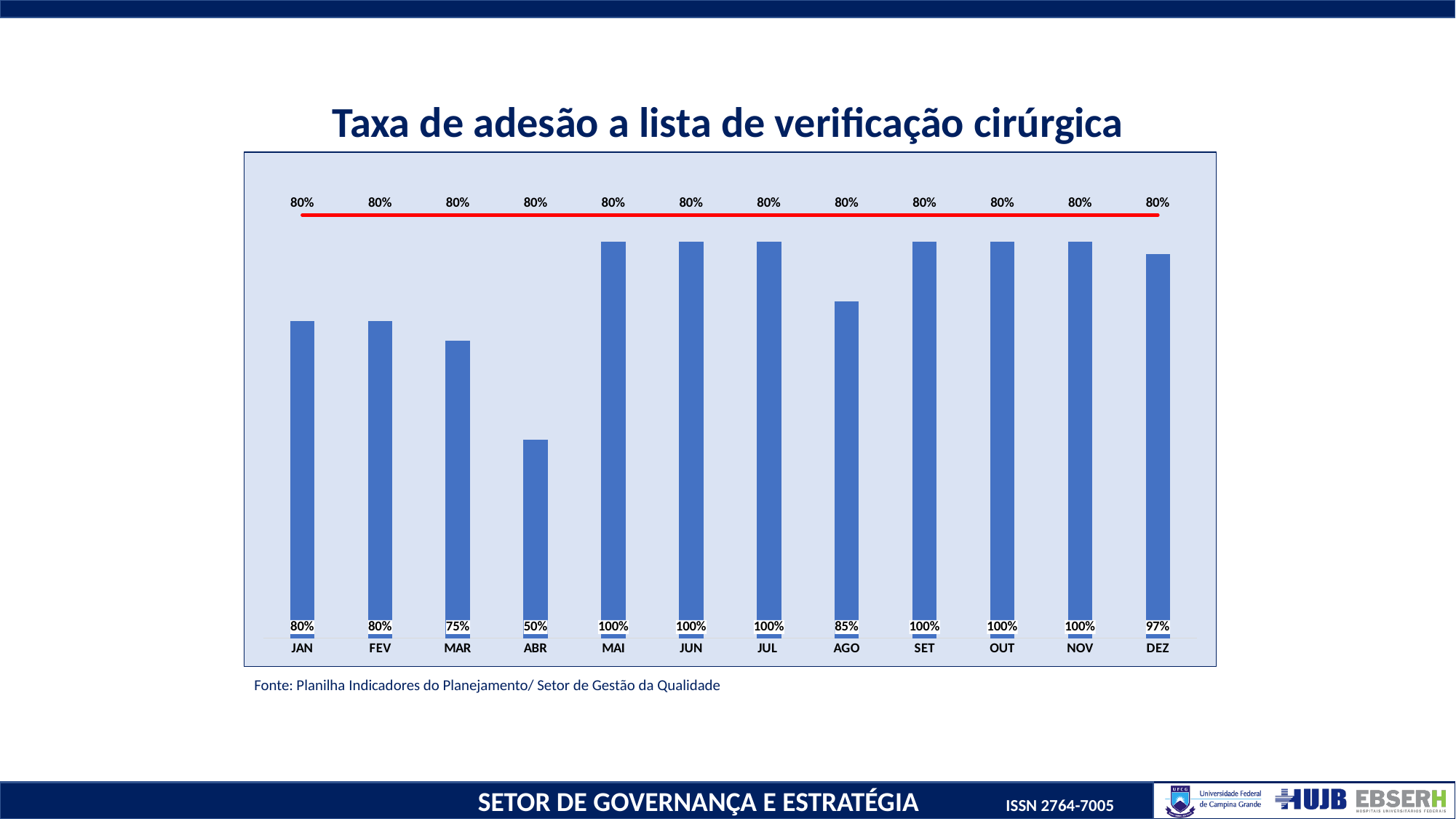
How many months are shown on the x axis? 12 What is the value for AGO? 85% What kind of chart is this? Combination bar and line chart What is the difference between the values for MAI and ABR? 50% What is the title of the chart? Taxa de adesão a lista de verificação cirúrgica What is the difference between the values for DEZ and AGO? 12% What is the value for ABR? 50% Which month has the lowest value? ABR What is the value for MAR? 75% Which is larger, the value for FEV or the value for MAR? FEV What is the target value marked by the red line? 80% What is the value for DEZ? 97%